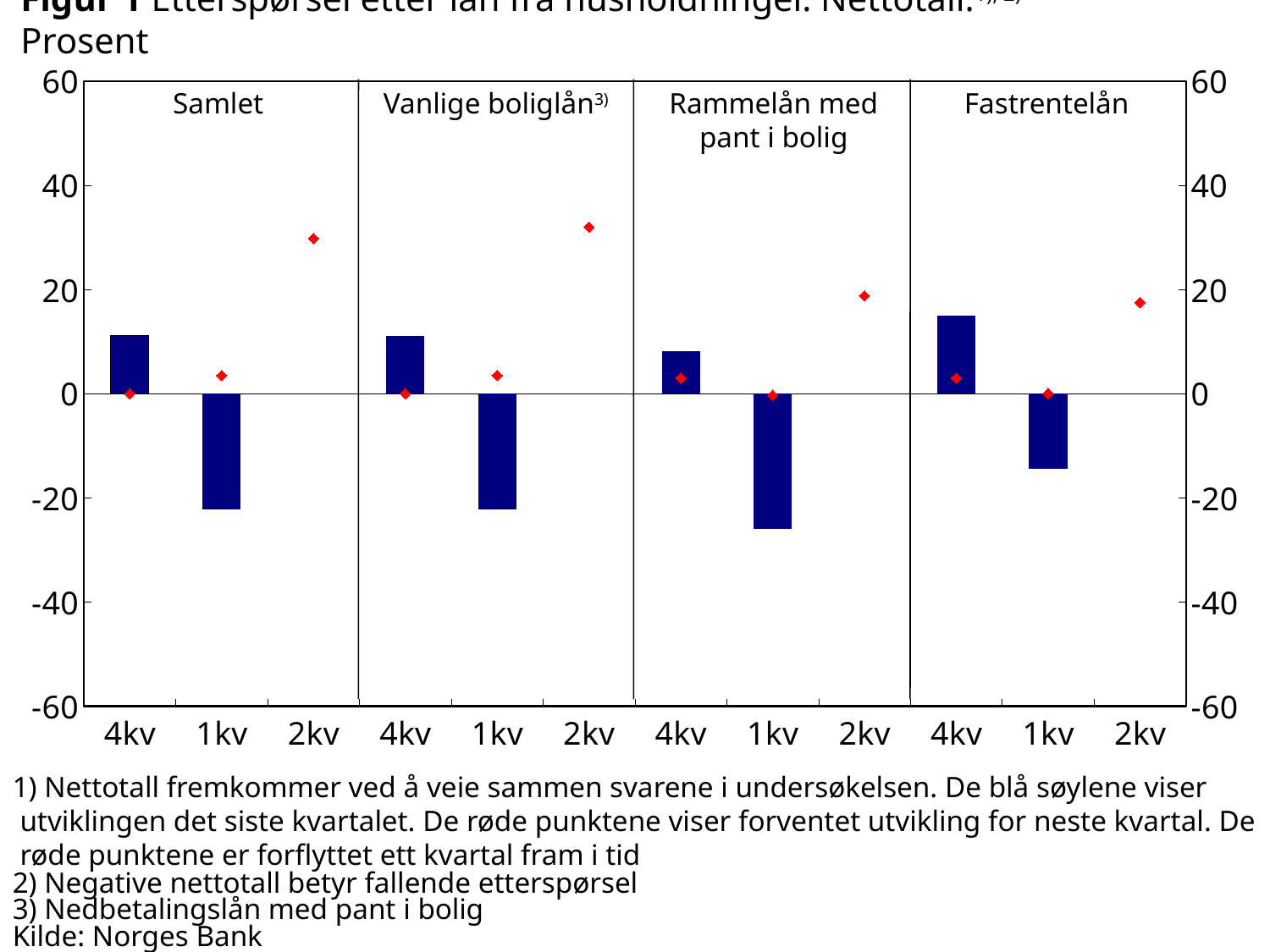
Which panel has the lowest bar for 1kv? Rammelån med pant i bolig What is the range of the y axis? -60 to 60 What kind of chart is shown on the slide? bar chart In the Vanlige boliglån panel, is the red point for 2kv greater or less than 20? greater How many quarters are shown on the x axis of each panel? 3 In the Rammelån med pant i bolig panel, is the bar for 1kv greater or less than -20? less In the Samlet panel, is the bar for 1kv greater or less than -20? less How many panels (loan categories) does the chart have? 4 Which panel has the highest bar for 4kv? Fastrentelån Is the 4kv bar larger in the Samlet panel or in the Fastrentelån panel? Fastrentelån